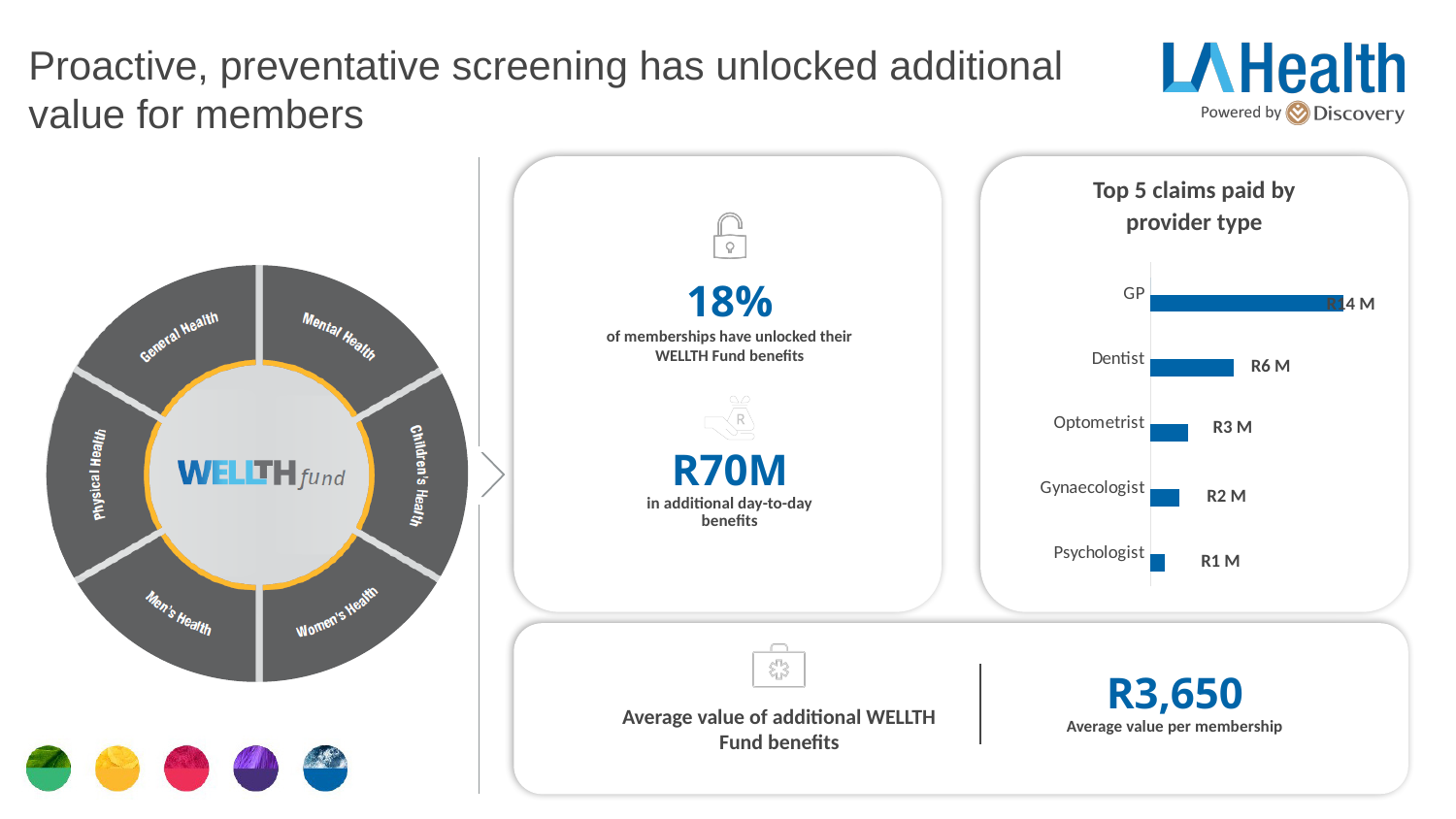
In the 'Top 5 claims paid by provider type' chart, what is the value for Psychologist? R1 M In the 'Top 5 claims paid by provider type' chart, what is the value for Dentist? R6 M In the 'Top 5 claims paid by provider type' chart, which is larger: Gynaecologist or Psychologist? Gynaecologist In the 'Top 5 claims paid by provider type' chart, what is the value for GP? R14 M What type of chart is used for 'Top 5 claims paid by provider type'? bar chart In the 'Top 5 claims paid by provider type' chart, what is the value for Gynaecologist? R2 M In the 'Top 5 claims paid by provider type' chart, what is the value for Optometrist? R3 M In the 'Top 5 claims paid by provider type' chart, which provider type has the highest claims paid? GP What is the title of the bar chart on the slide? Top 5 claims paid by provider type In the 'Top 5 claims paid by provider type' chart, what is the difference between the Dentist and Optometrist values? R3 M In the 'Top 5 claims paid by provider type' chart, which provider type has the lowest claims paid? Psychologist How many provider types are shown in the 'Top 5 claims paid by provider type' chart? 5